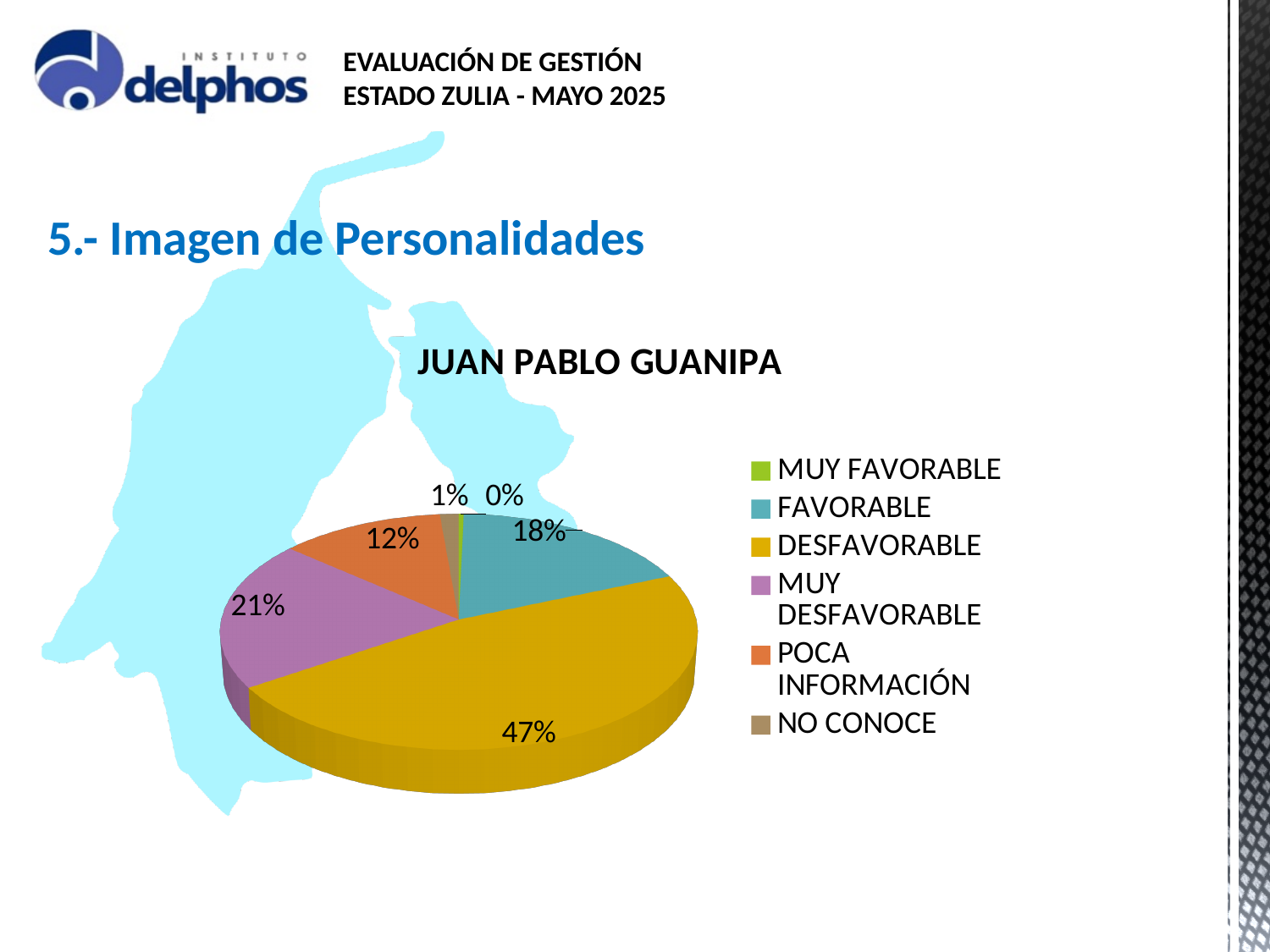
What kind of chart is shown on the slide? pie chart Which category has the smallest share of the pie? MUY FAVORABLE Which is larger, the FAVORABLE share or the POCA INFORMACIÓN share? FAVORABLE What percentage of the pie is DESFAVORABLE? 47% What percentage of the pie is POCA INFORMACIÓN? 12% What colour is the DESFAVORABLE slice? gold/yellow What is the difference between the DESFAVORABLE and MUY DESFAVORABLE shares? 26% What percentage of the pie is FAVORABLE? 18% What percentage of the pie is MUY DESFAVORABLE? 21% What is the title of the chart? JUAN PABLO GUANIPA How many categories does the legend list? 6 Which category has the largest share of the pie? DESFAVORABLE